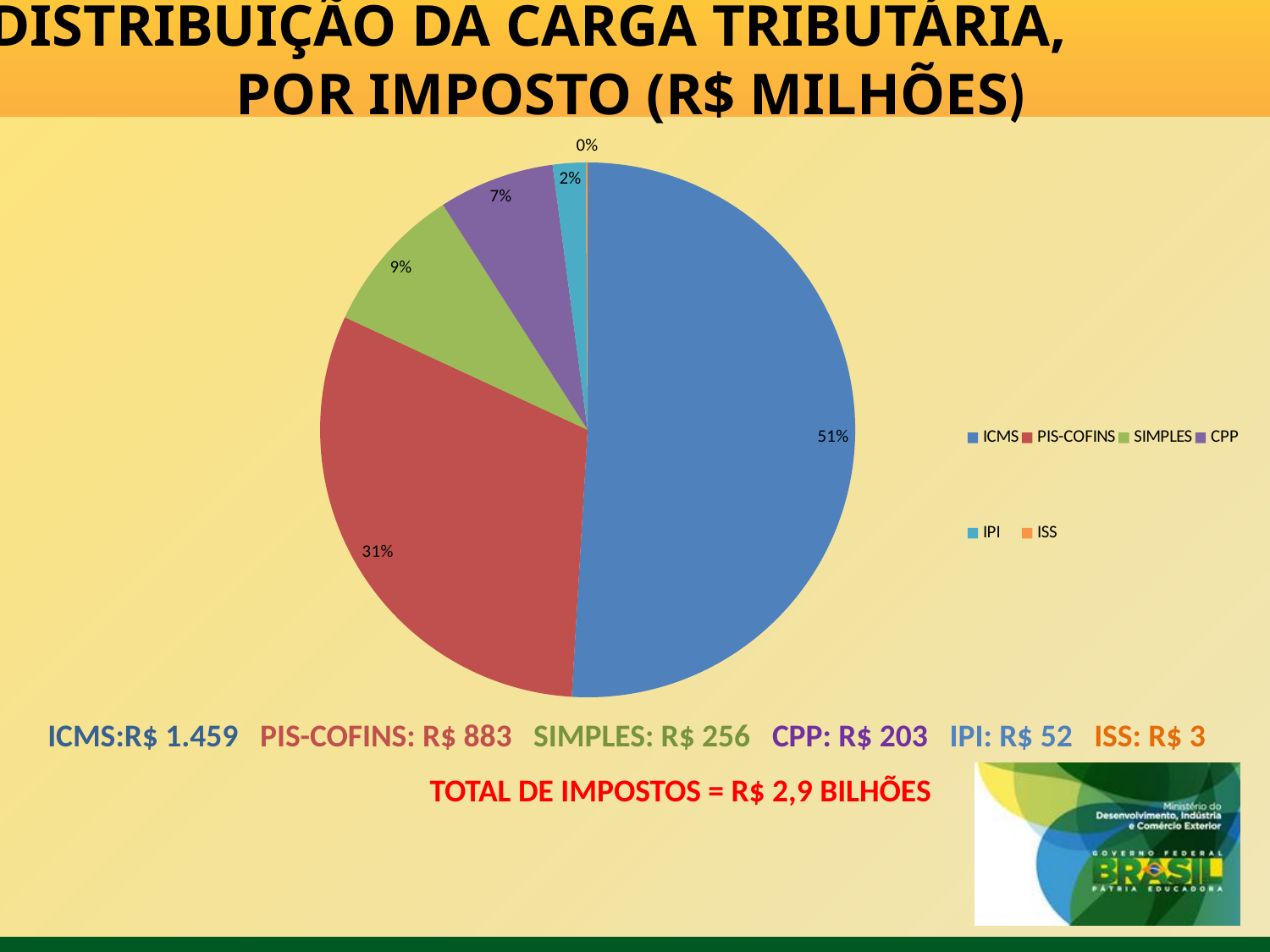
What share of the pie does IPI represent? 2% What is the difference in percentage points between the ICMS slice and the PIS-COFINS slice? 20 percentage points Which tax has the largest slice of the pie? ICMS What share of the pie does CPP represent? 7% What share of the pie does PIS-COFINS represent? 31% What type of chart is shown on the slide? pie chart Which tax has the smallest slice of the pie? ISS Which slice is larger, SIMPLES or CPP? SIMPLES How many entries does the legend list? 6 How many slices (categories) does the pie chart have? 6